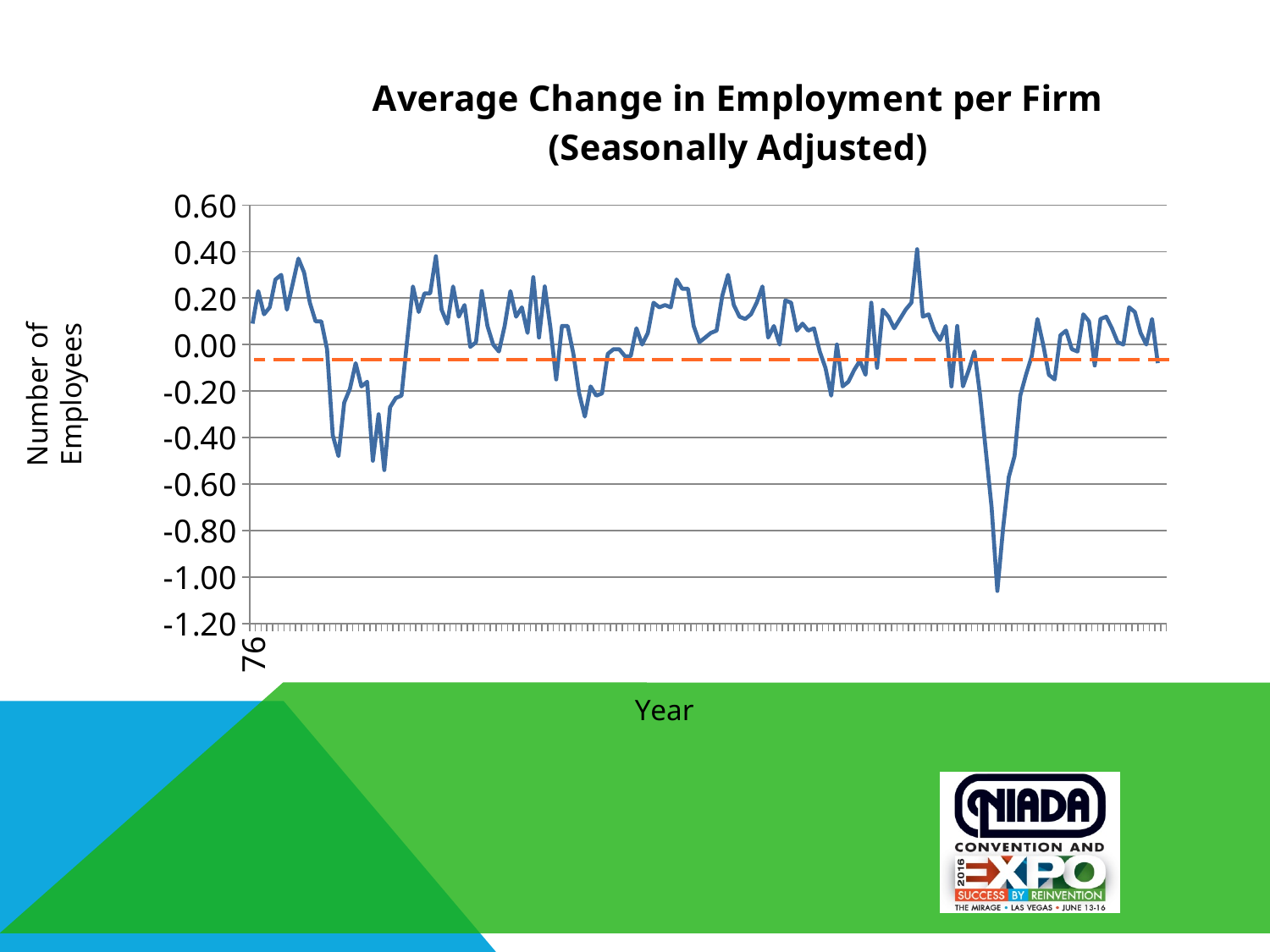
What is the label on the vertical axis of the chart? Number of Employees What is the title of the chart? Average Change in Employment per Firm (Seasonally Adjusted) Is the lowest point of the blue line greater or less than -1.00? less Is the highest point of the blue line greater or less than 0.60? less What kind of chart is shown on the slide? line chart Is the orange dashed line greater or less than 0.00? less